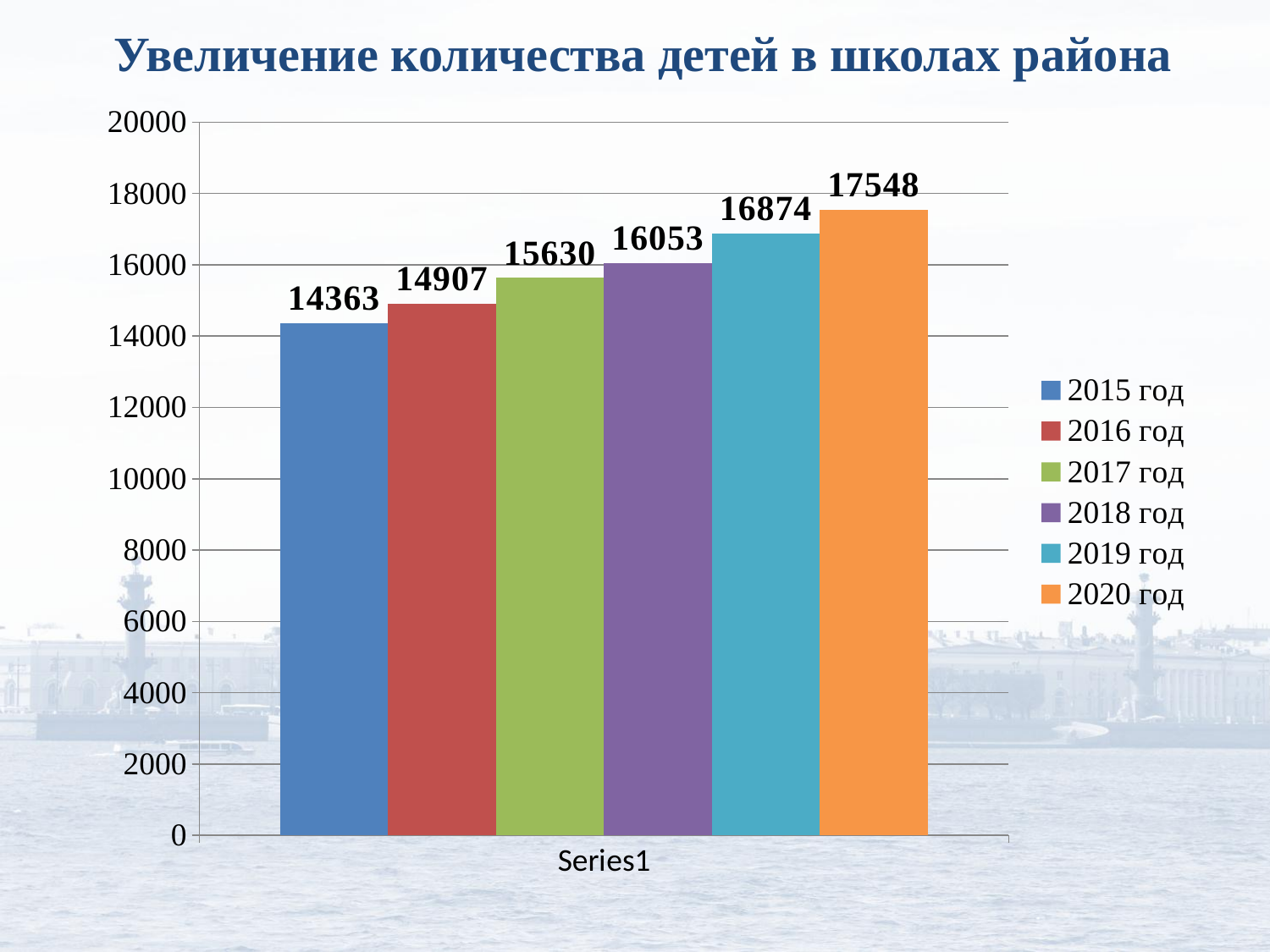
Is the value for 2016 год greater or less than 16000? less What is the difference between the values for 2020 год and 2015 год? 3185 How many series does the legend list? 6 What is the value for 2020 год? 17548 Which year has the lowest value? 2015 год What is the value for 2018 год? 16053 Which is larger, the value for 2019 год or the value for 2018 год? 2019 год Do the values rise or fall from 2015 год to 2020 год? rise What kind of chart is shown? bar chart What is the difference between the values for 2017 год and 2016 год? 723 Which year has the highest value? 2020 год What is the value for 2015 год? 14363